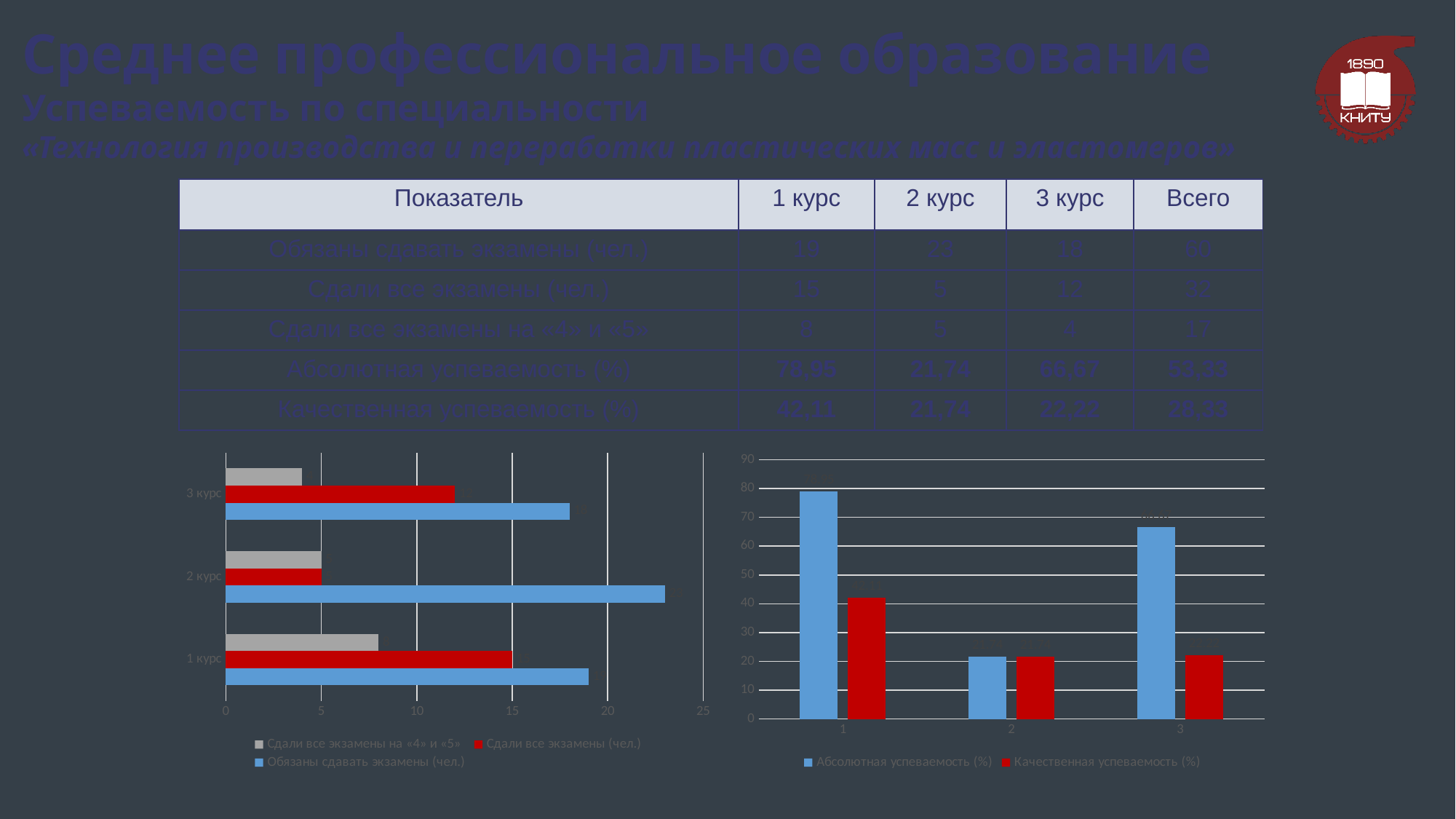
How many series does the legend of the right chart list? 2 What kind of chart is the chart on the right of the slide? bar chart In the right chart, is the value of Абсолютная успеваемость (%) for category 1 greater or less than 70? greater In the left chart, what is the value of Сдали все экзамены (чел.) for 1 курс? 15 In the right chart, which category has the lowest value for Абсолютная успеваемость (%)? 2 What kind of chart is the chart on the left of the slide? bar chart How many series does the legend of the left chart list? 3 How many categories does the left chart show? 3 In the left chart, what is the value of Сдали все экзамены (чел.) for 2 курс? 5 In the left chart, which category has the highest value for Обязаны сдавать экзамены (чел.)? 2 курс In the left chart, which category has the lowest value for Сдали все экзамены на «4» и «5»? 3 курс In the left chart, is the value of Обязаны сдавать экзамены (чел.) for 2 курс greater or less than 20? greater